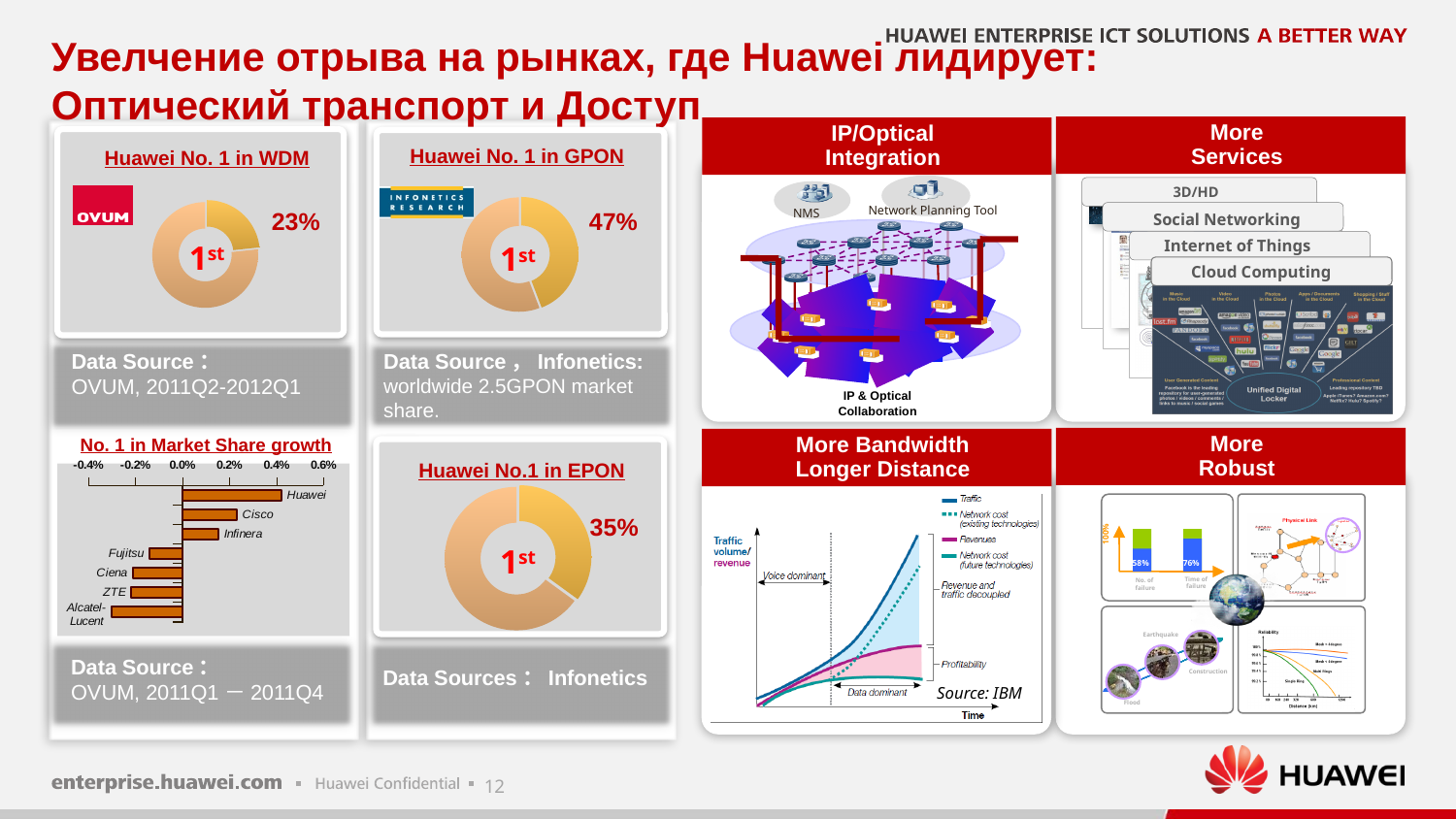
In the 'No. 1 in Market Share growth' bar chart, which company has the highest value? Huawei What kind of chart is 'No. 1 in Market Share growth'? Bar chart What is the difference between the GPON percentage (47%) and the WDM percentage (23%)? 24% In the 'Huawei No. 1 in WDM' donut chart, what market share percentage is shown? 23% In the 'No. 1 in Market Share growth' bar chart, is the value for Fujitsu greater or less than 0.0%? less How many companies are listed in the 'No. 1 in Market Share growth' bar chart? 7 Which is larger, the percentage in the GPON donut chart or the percentage in the EPON donut chart? GPON (47%) In the 'More Bandwidth Longer Distance' line chart, does the Traffic line rise or fall over Time? Rises What kind of chart is used for 'Huawei No. 1 in WDM'? Donut (pie) chart In the 'Huawei No. 1 in GPON' donut chart, what percentage is shown? 47% In the 'Huawei No.1 in EPON' donut chart, what percentage is shown? 35%